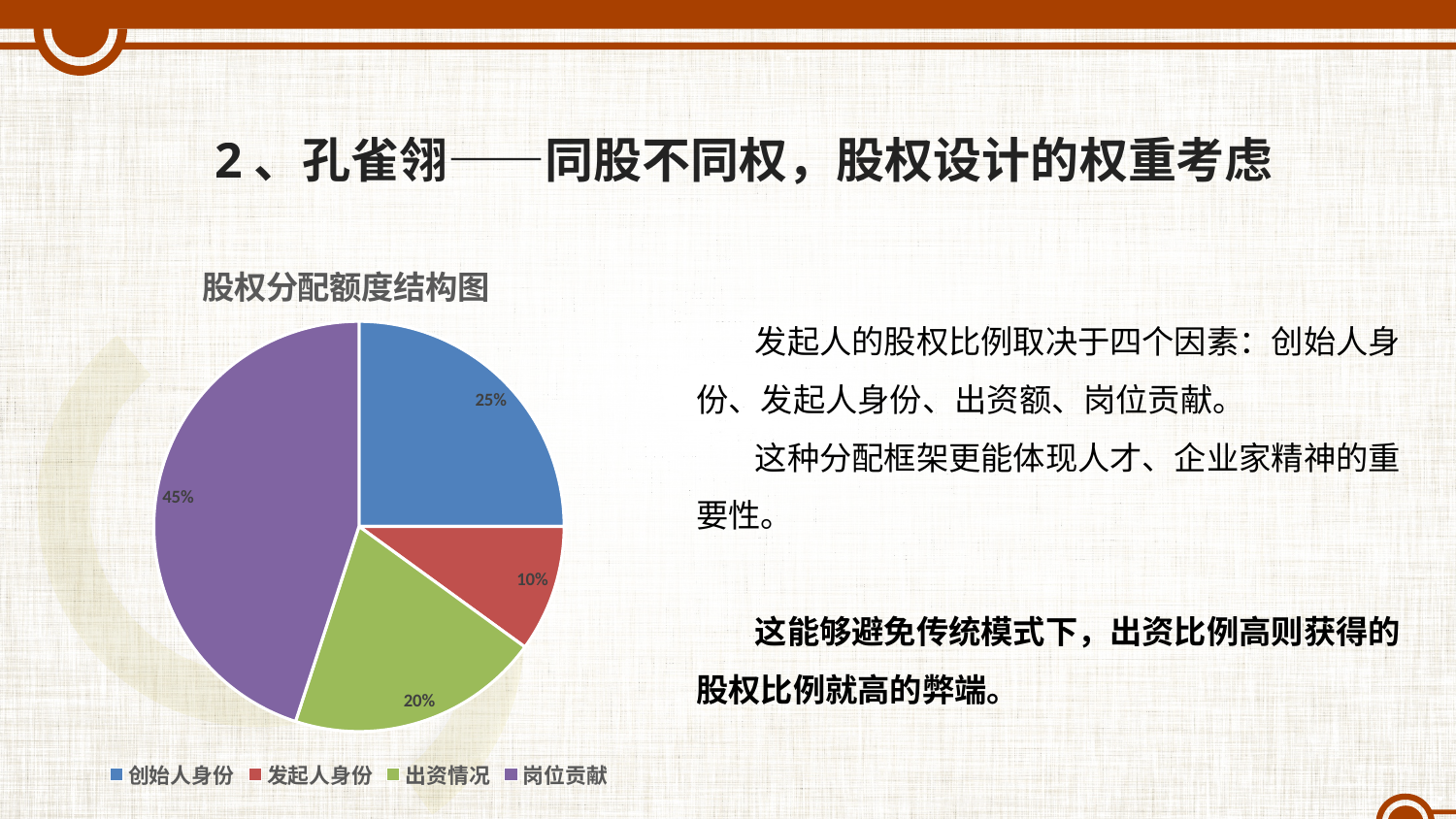
How many categories does the pie chart show? 4 What colour is the slice for 岗位贡献? Purple Which category has the largest slice of the pie? 岗位贡献 What kind of chart is shown on the slide? Pie chart Which category has the smallest slice of the pie? 发起人身份 What share of the pie does 出资情况 take? 20% Which is larger, the slice for 出资情况 or the slice for 发起人身份? 出资情况 What share of the pie does 岗位贡献 take? 45% What is the title of the chart? 股权分配额度结构图 What is the difference in percentage points between 岗位贡献 and 创始人身份? 20 What share of the pie does 发起人身份 take? 10%